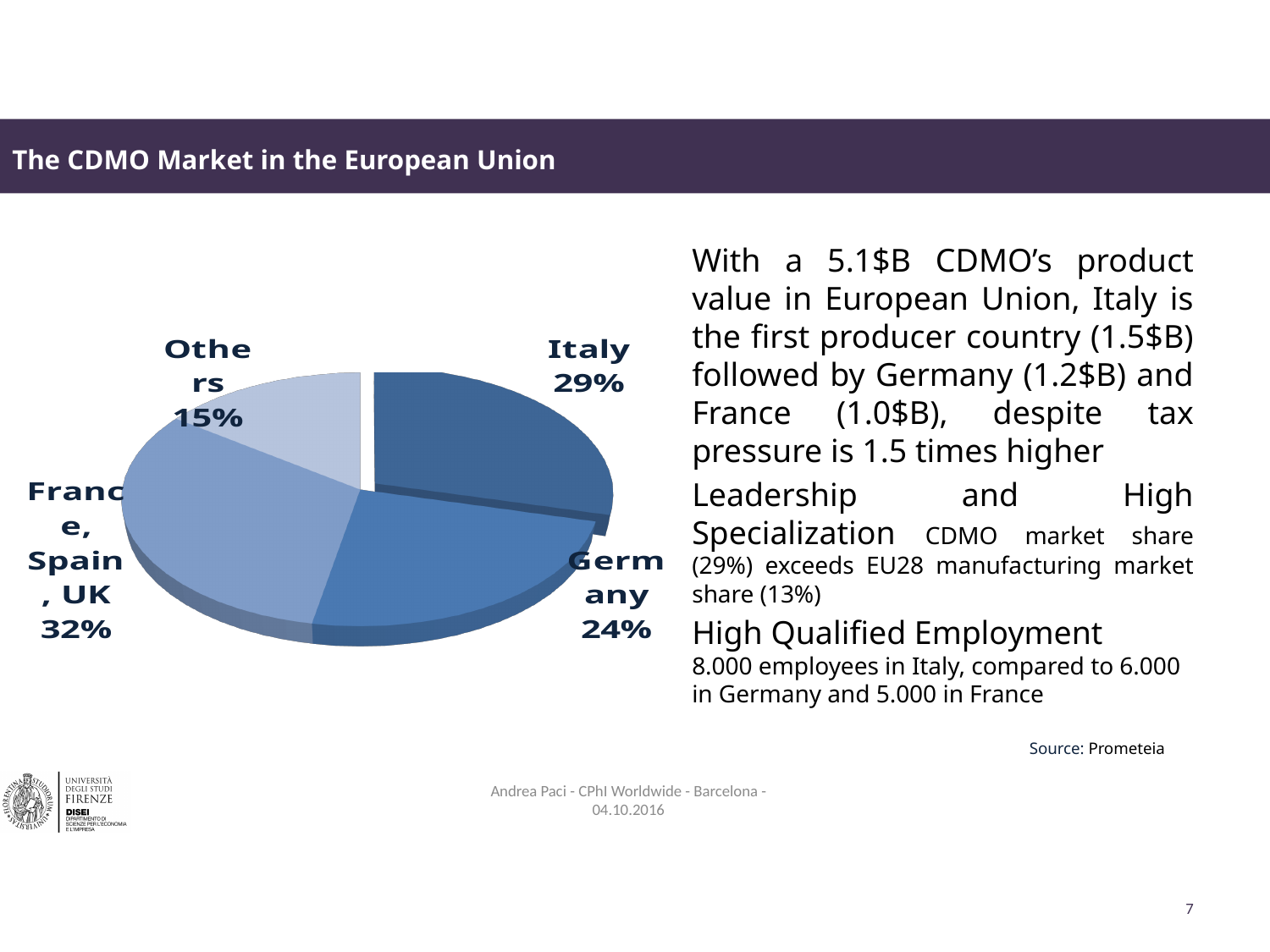
What share of the pie does Italy hold? 29% What is the difference in percentage points between the France, Spain, UK slice and the Others slice? 17% Which is larger, the share for Italy or the share for Others? Italy Which slice of the pie is the largest? France, Spain, UK What kind of chart is shown on the slide? Pie chart How many slices does the pie chart have? 4 What share of the pie does Others hold? 15% What share of the pie does Germany hold? 24% Which slice of the pie is the smallest? Others What is the title of the slide containing the pie chart? The CDMO Market in the European Union What share of the pie does the France, Spain, UK slice hold? 32% What is the difference in percentage points between Italy's share and Germany's share? 5%